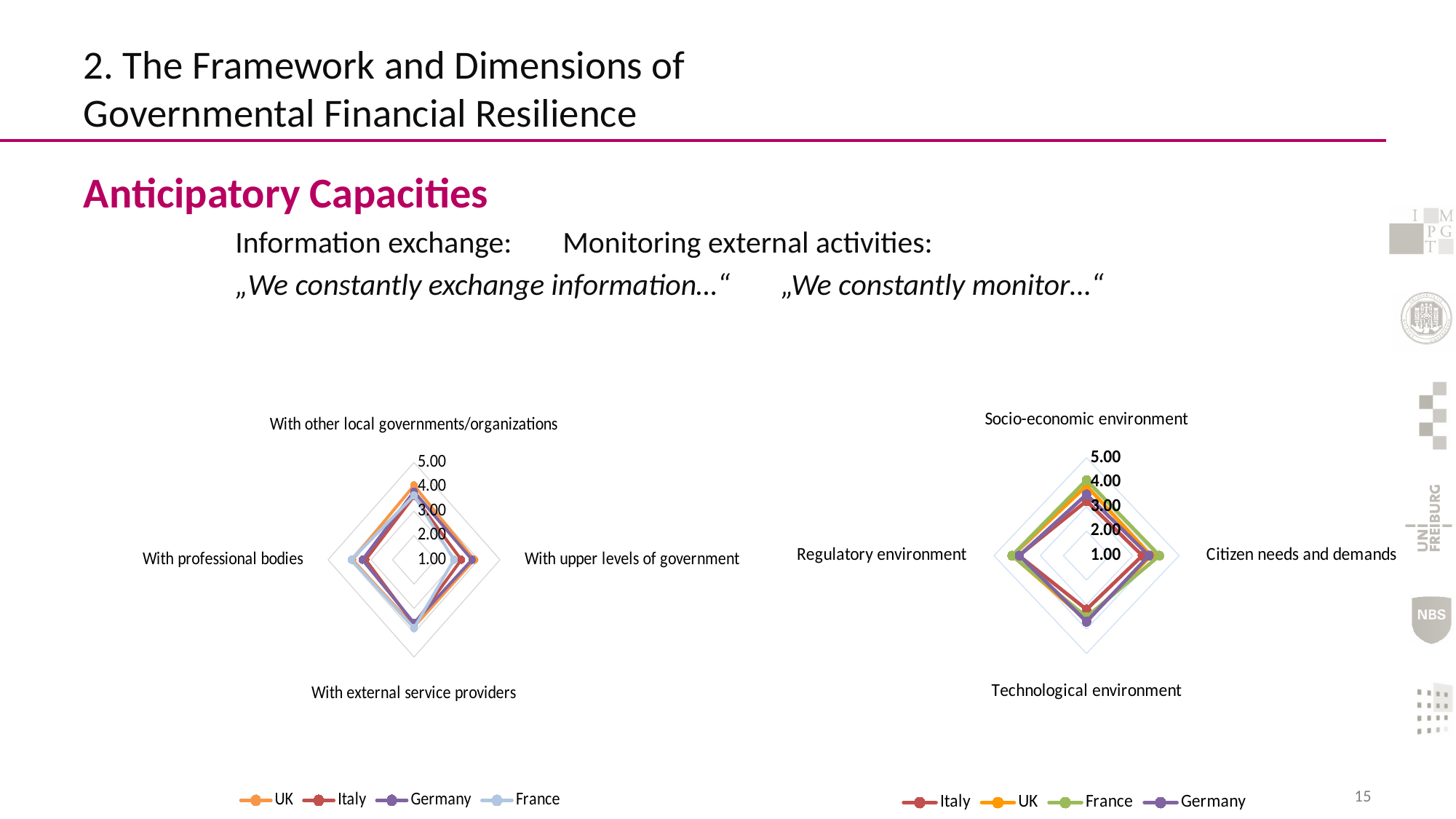
In the right chart (Monitoring external activities), is the value for Germany on Technological environment greater or less than 3.00? greater In the right chart (Monitoring external activities), is the value for Italy on Citizen needs and demands greater or less than 4.00? less In the left chart (Information exchange), is the value for UK on With other local governments/organizations greater or less than 3.00? greater How many categories (axes) does the left chart (Information exchange) have? 4 Which countries are listed in the legend of the left chart (Information exchange)? UK, Italy, Germany, France How many series does the legend of the right chart (Monitoring external activities) list? 4 In the right chart (Monitoring external activities), which is higher on Socio-economic environment: France or Italy? France What type of chart is the left chart (Information exchange)? Radar chart In the left chart (Information exchange), which is higher on With professional bodies: France or Germany? France What is the highest value shown on the axis scale of the right chart (Monitoring external activities)? 5.00